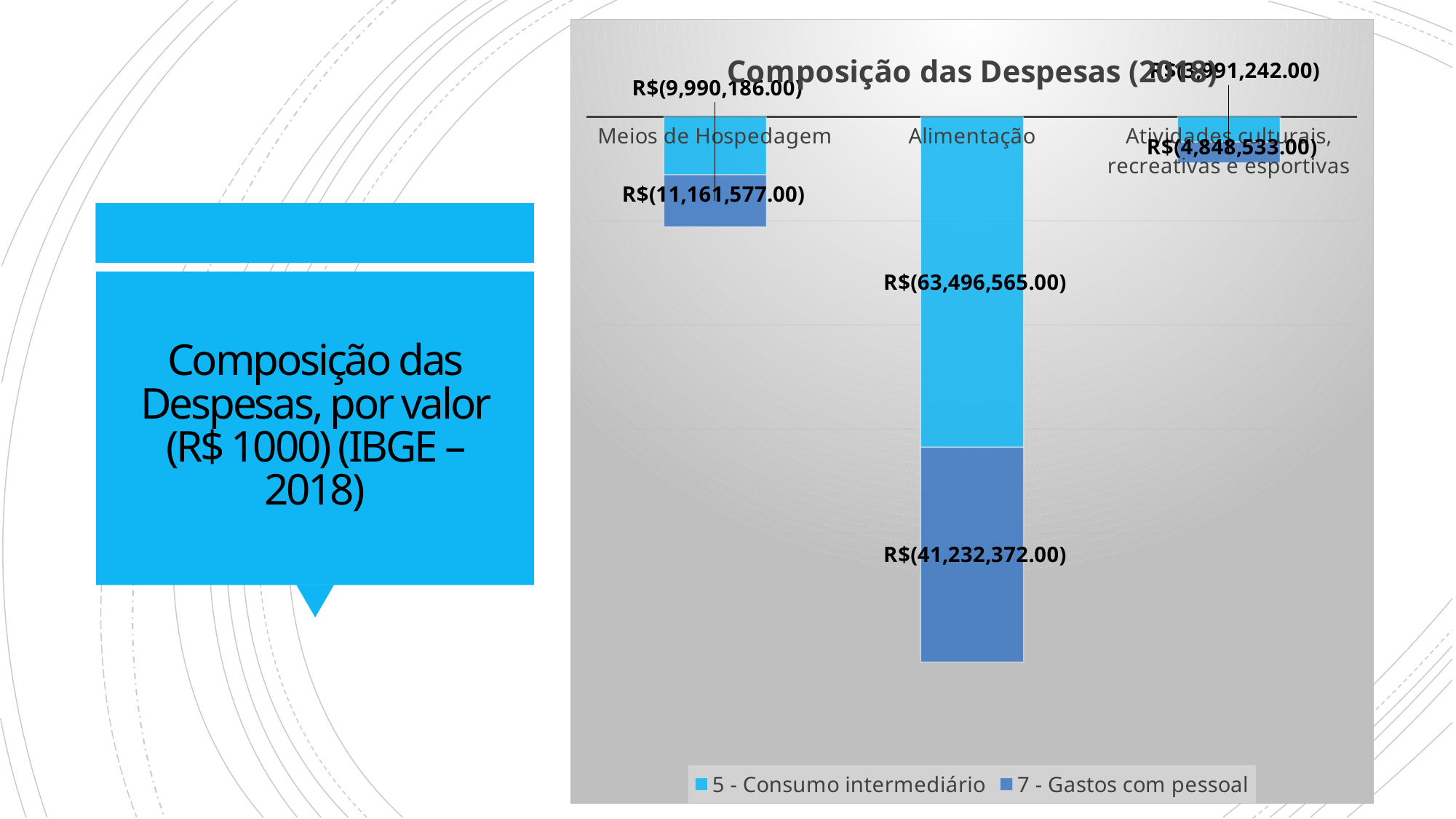
What is the title of the chart? Composição das Despesas (2018) How many categories are shown on the x axis? 3 How many series does the legend list? 2 What type of chart is shown on the slide? stacked bar chart What is the value of '7 - Gastos com pessoal' for Atividades culturais, recreativas e esportivas? R$(3,991,242.00) Which category has the largest total stacked bar? Alimentação What is the value of '5 - Consumo intermediário' for Alimentação? R$(63,496,565.00) What is the difference between the '5 - Consumo intermediário' and '7 - Gastos com pessoal' values for Alimentação? R$22,264,193.00 What is the value of '7 - Gastos com pessoal' for Meios de Hospedagem? R$(9,990,186.00) What is the value of '7 - Gastos com pessoal' for Alimentação? R$(41,232,372.00) What is the value of '5 - Consumo intermediário' for Meios de Hospedagem? R$(11,161,577.00) Which category has the smallest total stacked bar? Atividades culturais, recreativas e esportivas